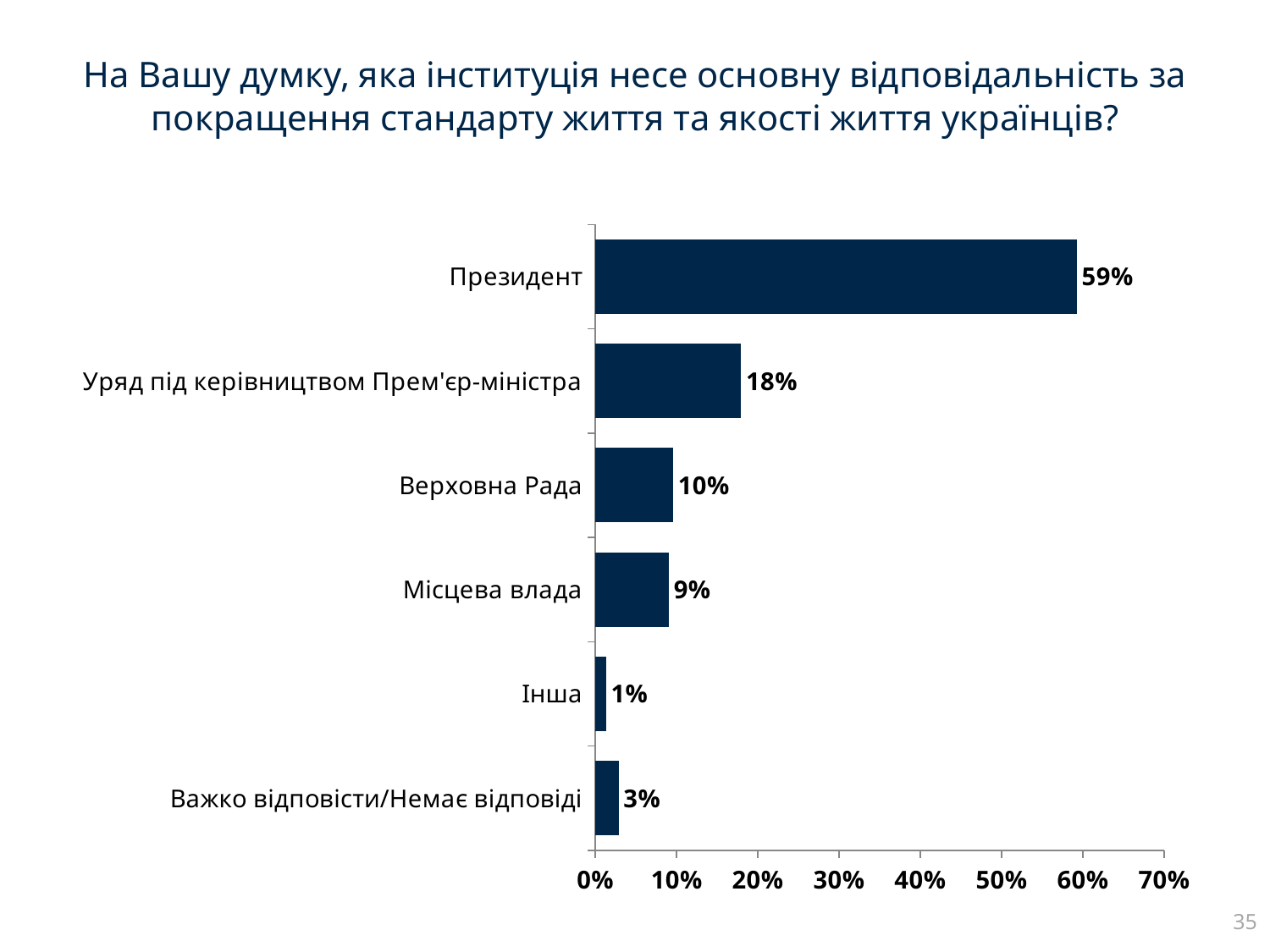
What is the value for Важко відповісти/Немає відповіді? 3% What is the value for Президент? 59% What is the value for Верховна Рада? 10% Which category has the lowest value? Інша How many categories are shown in the chart? 6 What kind of chart is shown on the slide? bar chart What is the difference between the values for Президент and Уряд під керівництвом Прем'єр-міністра? 41% What is the difference between the values for Верховна Рада and Місцева влада? 1% What is the value for Уряд під керівництвом Прем'єр-міністра? 18% Which is larger, the value for Місцева влада or the value for Важко відповісти/Немає відповіді? Місцева влада Which category has the highest value? Президент Is the value for Президент greater or less than 50%? greater